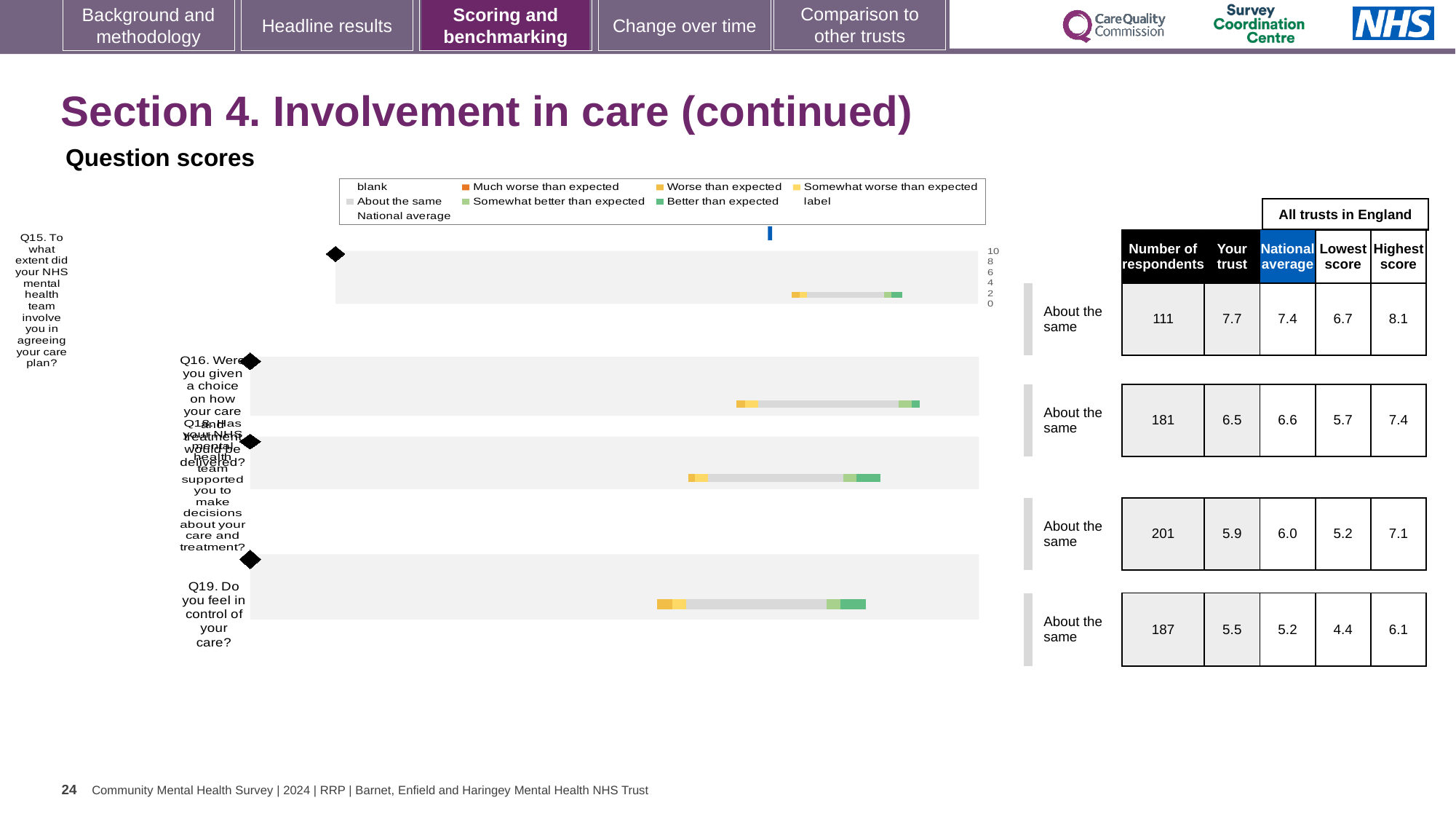
What benchmark category is shown next to the Q15 bar? About the same Which question has the highest 'Your trust' score? Q15 What kind of chart is used to show the question scores on this slide? Bar chart What is the difference between the highest score (8.1) and the lowest score (6.7) for Q15? 1.4 How many questions (categories) are plotted in the question scores chart? 4 Which question has the lowest 'Your trust' score? Q19 What is the lowest score among all trusts in England for Q18? 5.2 What is the 'Your trust' score for Q15 (involvement in agreeing your care plan)? 7.7 For Q16, which is larger: the 'Your trust' score or the national average? National average What colour does the legend use for 'Better than expected'? Green What is the national average score for Q19 (feeling in control of your care)? 5.2 How many respondents are listed for Q18 (supported to make decisions about care and treatment)? 201